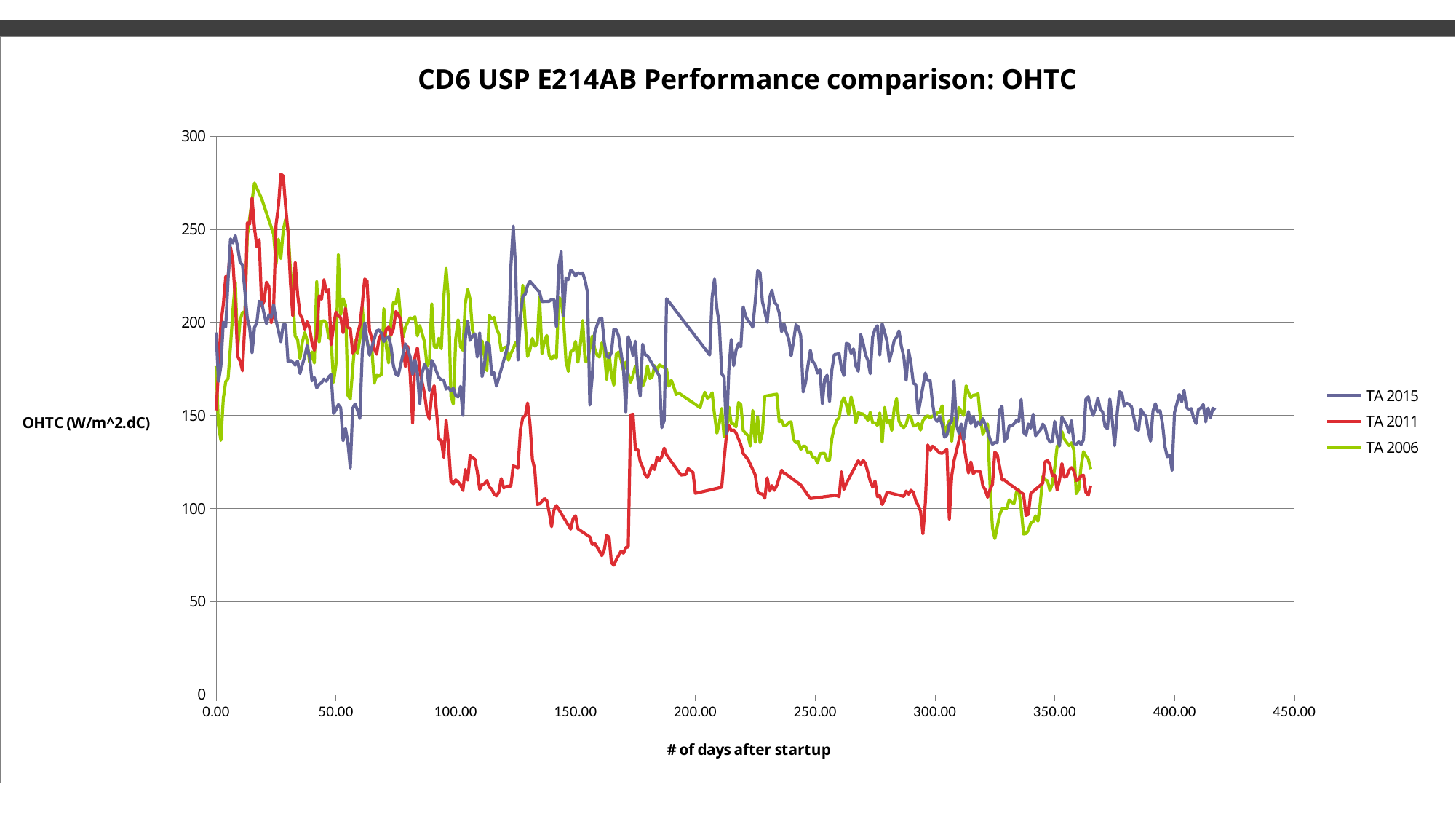
What is the label of the x axis? # of days after startup What is the title of the chart? CD6 USP E214AB Performance comparison: OHTC At around 200 days after startup, which series has the larger value, TA 2015 or TA 2011? TA 2015 Does the TA 2015 series generally rise or fall between day 0 and day 400? fall Which series extends the furthest along the x axis (to the largest number of days after startup)? TA 2015 Does the TA 2011 series generally rise or fall as the number of days after startup increases? fall Is the value of TA 2011 at around 160 days after startup greater or less than 100? less Is the value of TA 2006 at around 50 days after startup greater or less than 150? greater Which series reaches the lowest OHTC value anywhere on the chart? TA 2011 Is the value of TA 2015 at around 400 days after startup greater or less than 100? greater What kind of chart is shown on the slide? line chart How many series does the legend list? 3